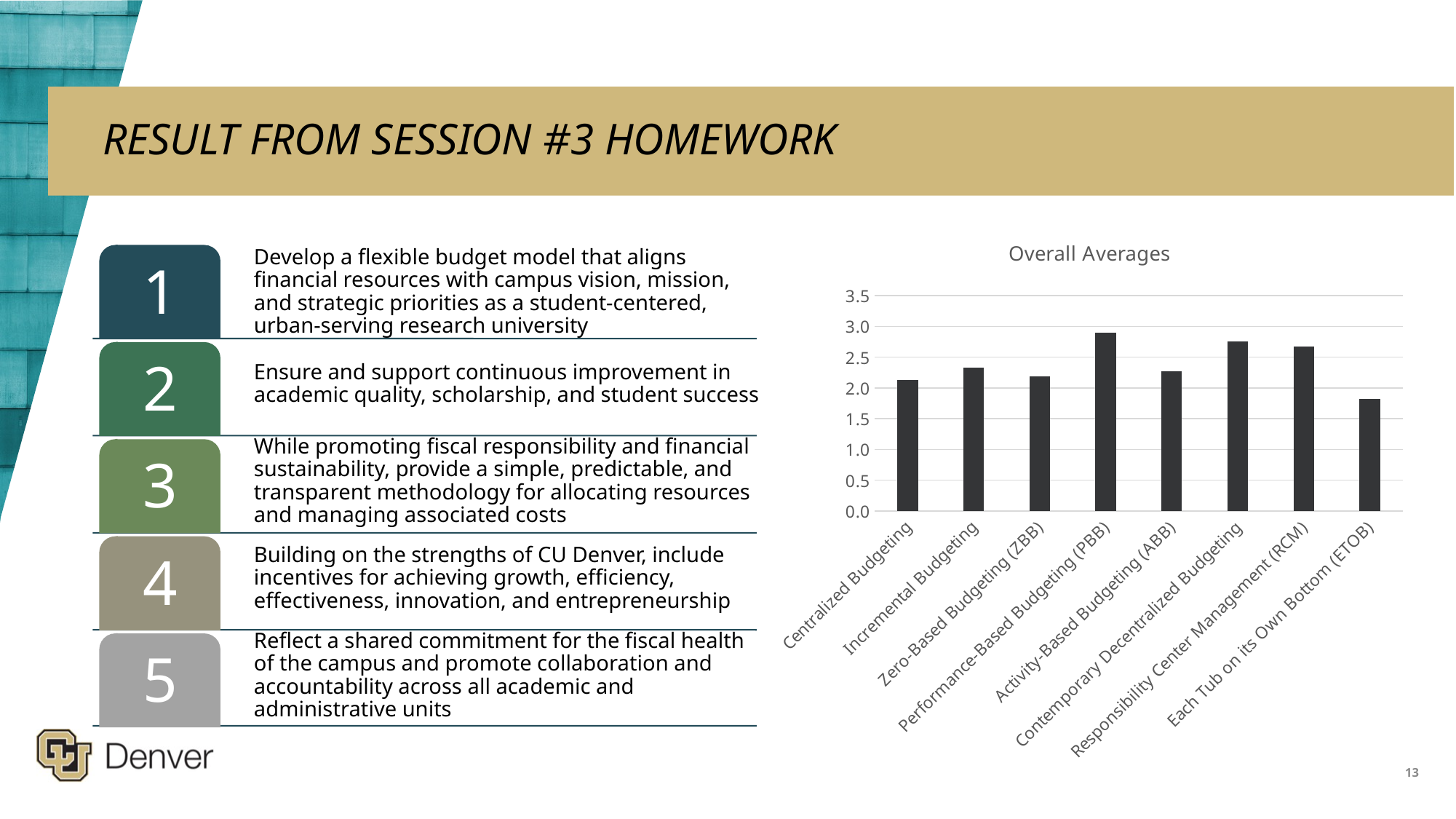
Which has a higher overall average: Zero-Based Budgeting (ZBB) or Each Tub on its Own Bottom (ETOB)? Zero-Based Budgeting (ZBB) Is the value for Each Tub on its Own Bottom (ETOB) greater or less than 2.0? less Which budgeting model has the lowest overall average? Each Tub on its Own Bottom (ETOB) Is the value for Performance-Based Budgeting (PBB) greater or less than 2.5? greater Which budgeting model has the highest overall average? Performance-Based Budgeting (PBB) Is the value for Incremental Budgeting greater or less than 2.5? less What kind of chart is shown on the slide? Bar chart What is the highest value shown on the chart's vertical axis? 3.5 How many budgeting models (categories) are plotted in the chart? 8 What is the title of the chart? Overall Averages Which has a higher overall average: Responsibility Center Management (RCM) or Centralized Budgeting? Responsibility Center Management (RCM)